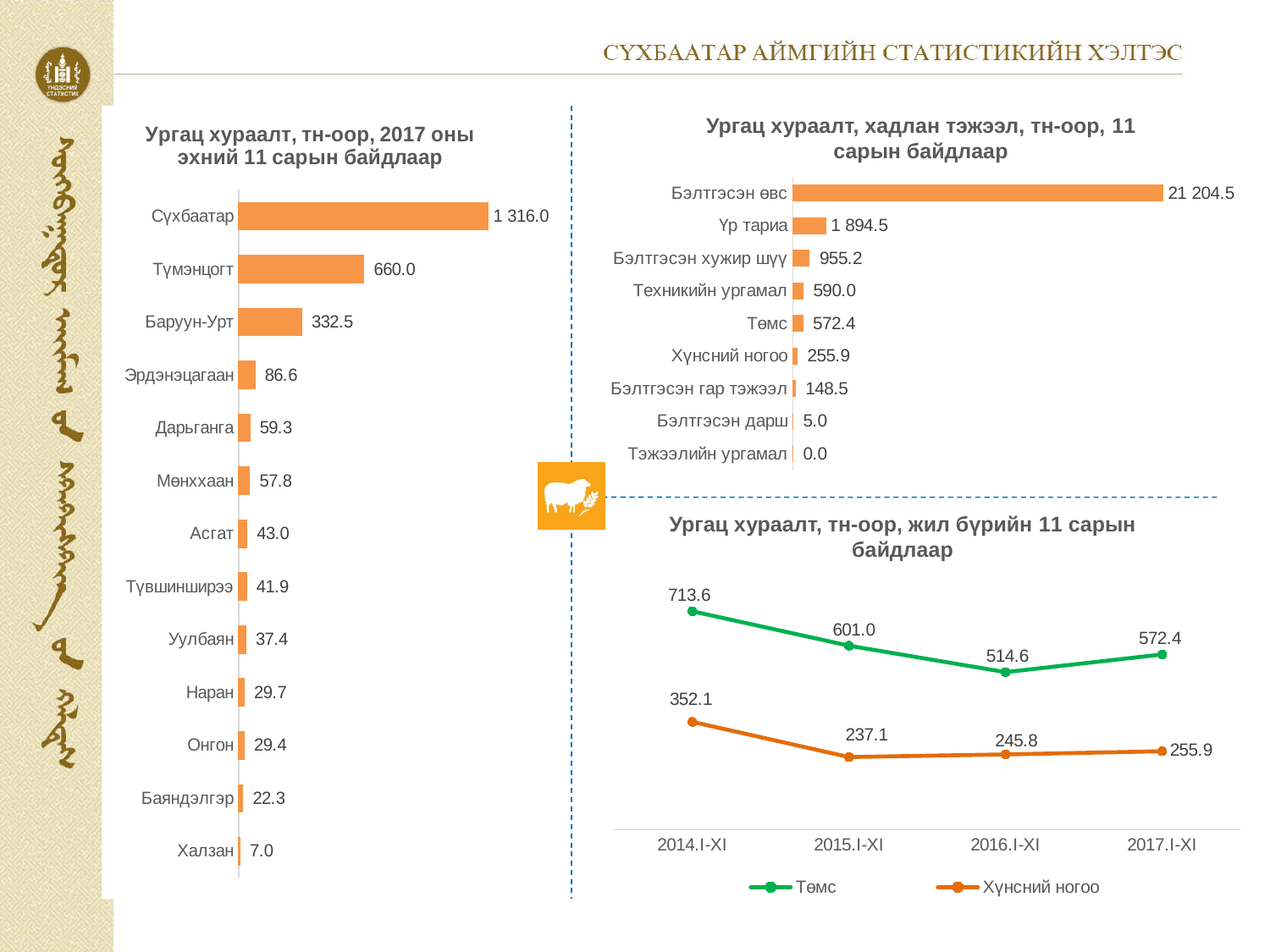
In the chart titled "Ургац хураалт, тн-оор, жил бүрийн 11 сарын байдлаар", how many series does the legend list? 2 What kind of chart is the one titled "Ургац хураалт, хадлан тэжээл, тн-оор, 11 сарын байдлаар"? Bar chart In the chart titled "Ургац хураалт, тн-оор, жил бүрийн 11 сарын байдлаар", what is the difference between Төмс and Хүнсний ногоо in 2014.I-XI? 361.5 In the chart titled "Ургац хураалт, тн-оор, 2017 оны эхний 11 сарын байдлаар", which category has the highest value? Сүхбаатар In the chart titled "Ургац хураалт, хадлан тэжээл, тн-оор, 11 сарын байдлаар", which category has the highest value? Бэлтгэсэн өвс In the chart titled "Ургац хураалт, тн-оор, 2017 оны эхний 11 сарын байдлаар", how many categories are shown? 13 In the chart titled "Ургац хураалт, тн-оор, 2017 оны эхний 11 сарын байдлаар", which category has the lowest value? Халзан In the chart titled "Ургац хураалт, тн-оор, жил бүрийн 11 сарын байдлаар", what is the value for Төмс in 2016.I-XI? 514.6 In the chart titled "Ургац хураалт, хадлан тэжээл, тн-оор, 11 сарын байдлаар", which is larger, Техникийн ургамал or Төмс? Техникийн ургамал In the chart titled "Ургац хураалт, тн-оор, 2017 оны эхний 11 сарын байдлаар", what is the value for Түмэнцогт? 660.0 In the chart titled "Ургац хураалт, тн-оор, 2017 оны эхний 11 сарын байдлаар", what is the difference between the values for Сүхбаатар and Түмэнцогт? 656.0 In the chart titled "Ургац хураалт, хадлан тэжээл, тн-оор, 11 сарын байдлаар", what is the value for Үр тариа? 1 894.5